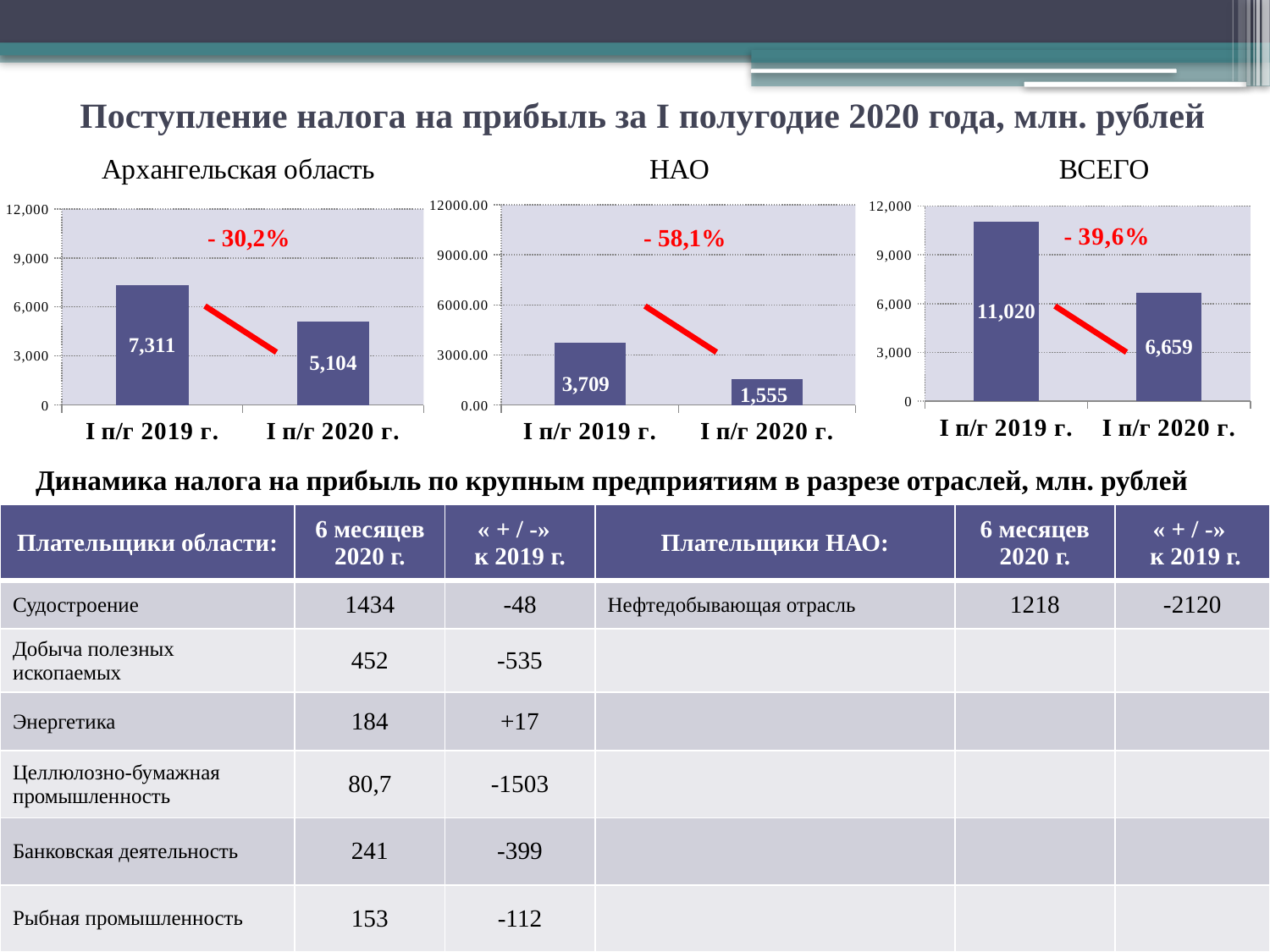
In the chart titled "Архангельская область", which category has the higher value, "I п/г 2019 г." or "I п/г 2020 г."? I п/г 2019 г. In the chart titled "НАО", what is the difference between the values for "I п/г 2019 г." and "I п/г 2020 г."? 2,154 What percentage change is printed on the chart titled "НАО"? - 58,1% In the chart titled "ВСЕГО", what is the difference between the values for "I п/г 2019 г." and "I п/г 2020 г."? 4,361 How many categories are shown in the chart titled "Архангельская область"? 2 In the chart titled "Архангельская область", what is the value for "I п/г 2019 г."? 7,311 In the chart titled "ВСЕГО", what is the value for "I п/г 2019 г."? 11,020 What kind of chart is the chart titled "НАО"? bar chart In the chart titled "НАО", is the value for "I п/г 2019 г." greater or less than 3000? greater In the chart titled "ВСЕГО", do the values rise or fall from "I п/г 2019 г." to "I п/г 2020 г."? fall In the chart titled "Архангельская область", what is the value for "I п/г 2020 г."? 5,104 In the chart titled "НАО", what is the value for "I п/г 2020 г."? 1,555